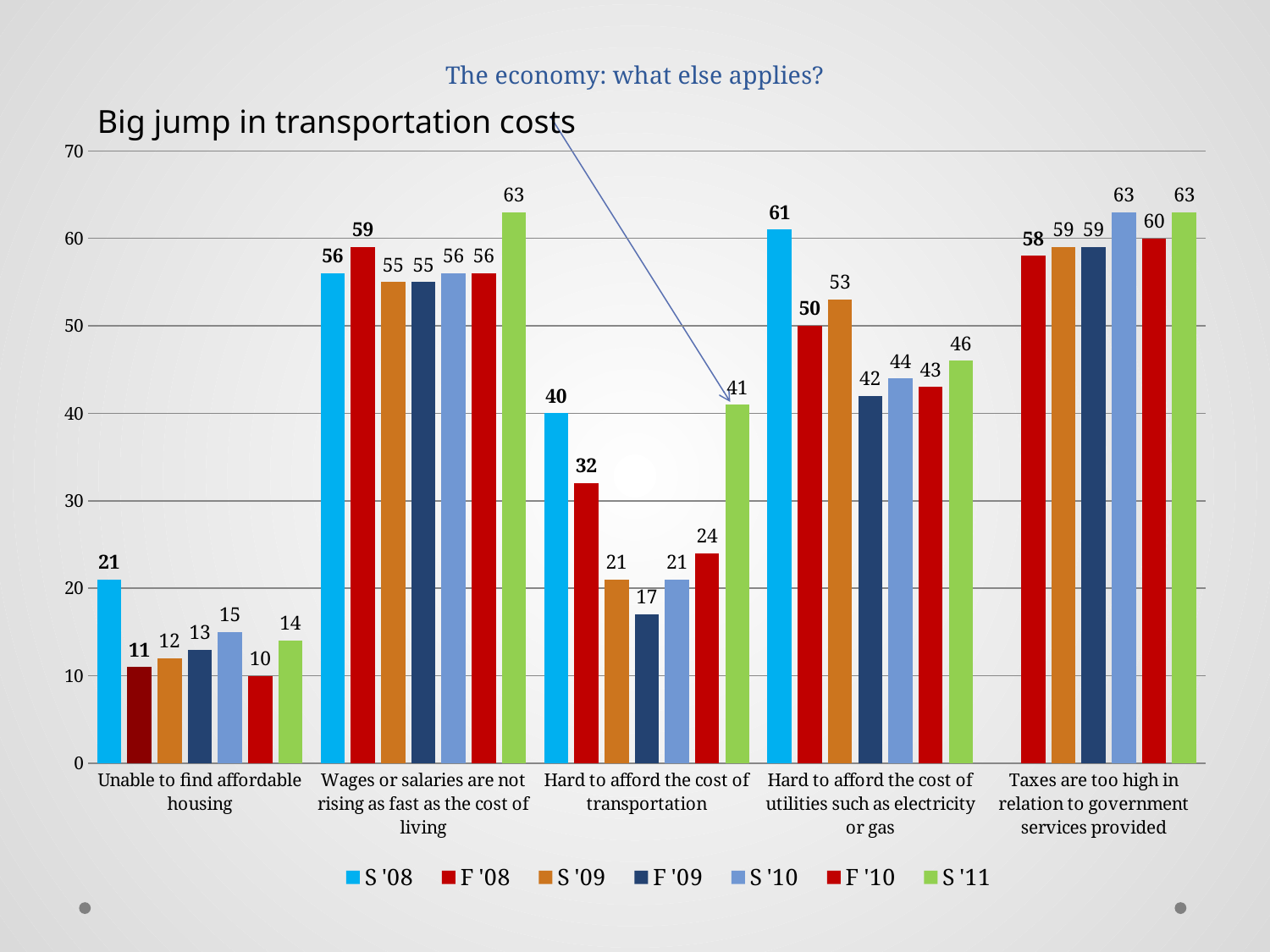
What is the F '09 value for 'Unable to find affordable housing'? 13 What is the difference between the S '11 and F '10 values for 'Hard to afford the cost of transportation'? 17 Which series has the highest value for 'Wages or salaries are not rising as fast as the cost of living'? S '11 What is the title of the chart? Big jump in transportation costs Which series has the lowest value for 'Hard to afford the cost of transportation'? F '09 How many categories are shown along the x axis? 5 How many series does the legend list? 7 What is the difference between the S '08 and F '08 values for 'Unable to find affordable housing'? 10 What is the S '08 value for 'Hard to afford the cost of utilities such as electricity or gas'? 61 What is the S '11 value for 'Hard to afford the cost of transportation'? 41 Which is larger for 'Hard to afford the cost of utilities such as electricity or gas': the S '09 value or the F '10 value? S '09 What kind of chart is shown on the slide? bar chart